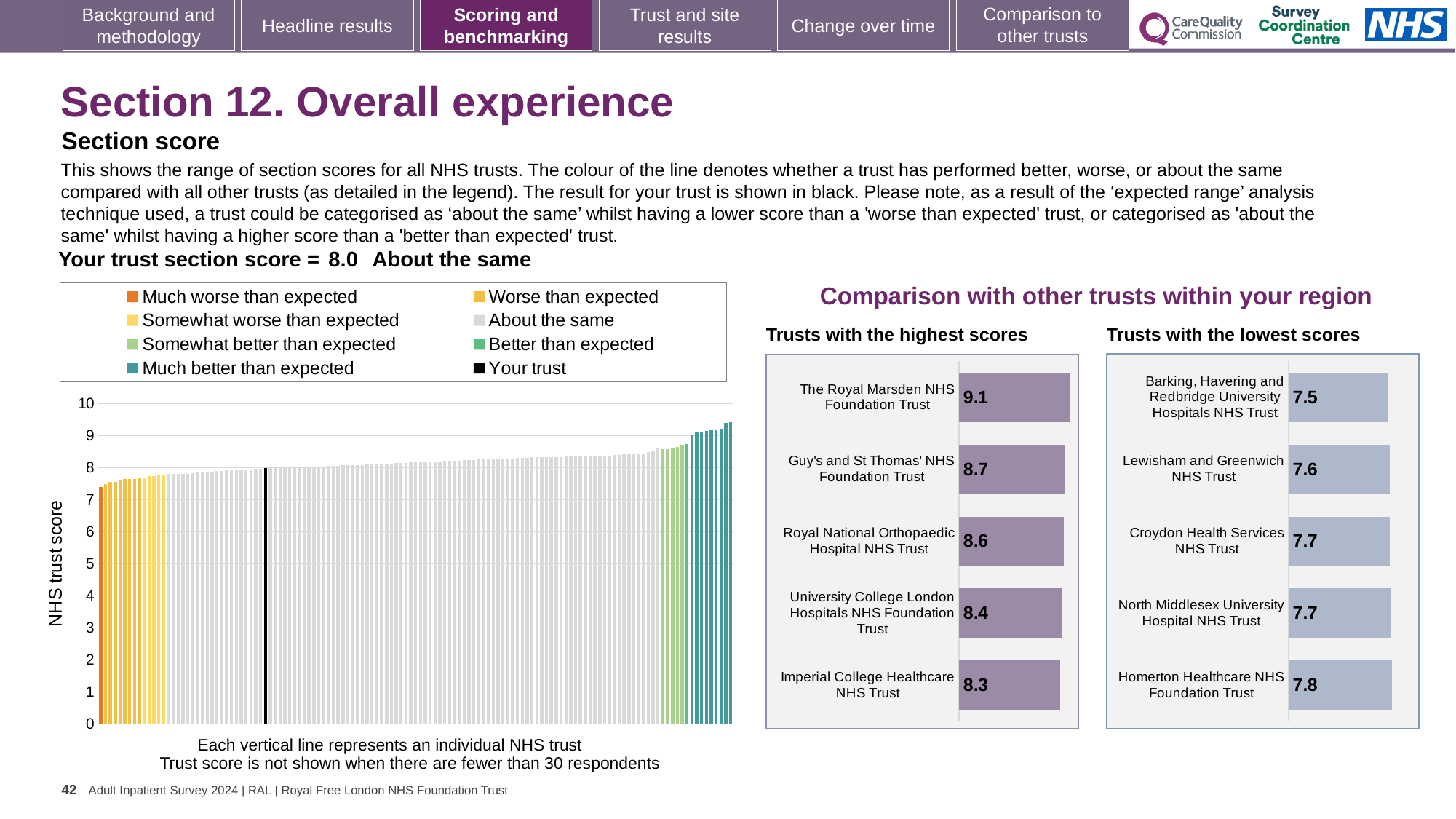
In the 'Trusts with the lowest scores' chart, what is the score for Lewisham and Greenwich NHS Trust? 7.6 How many entries does the legend of the 'NHS trust score' chart list? 8 In the 'Trusts with the highest scores' chart, what is the difference between the scores of The Royal Marsden NHS Foundation Trust and Imperial College Healthcare NHS Trust? 0.8 In the 'Trusts with the lowest scores' chart, which trust has the lowest score? Barking, Havering and Redbridge University Hospitals NHS Trust In the 'NHS trust score' chart, is the value for your trust (the black bar) greater or less than 5? greater What kind of chart is the 'NHS trust score' chart on the left of the slide? Bar chart In the 'Trusts with the highest scores' chart, what is the score for The Royal Marsden NHS Foundation Trust? 9.1 How many trusts are shown in the 'Trusts with the highest scores' chart? 5 In the 'Trusts with the lowest scores' chart, which has the higher score: Homerton Healthcare NHS Foundation Trust or Croydon Health Services NHS Trust? Homerton Healthcare NHS Foundation Trust According to the slide, what is your trust's section score for Overall experience? 8.0 In the 'Trusts with the highest scores' chart, which trust has the highest score? The Royal Marsden NHS Foundation Trust In the 'Trusts with the lowest scores' chart, what is the difference between the scores of Homerton Healthcare NHS Foundation Trust and Barking, Havering and Redbridge University Hospitals NHS Trust? 0.3